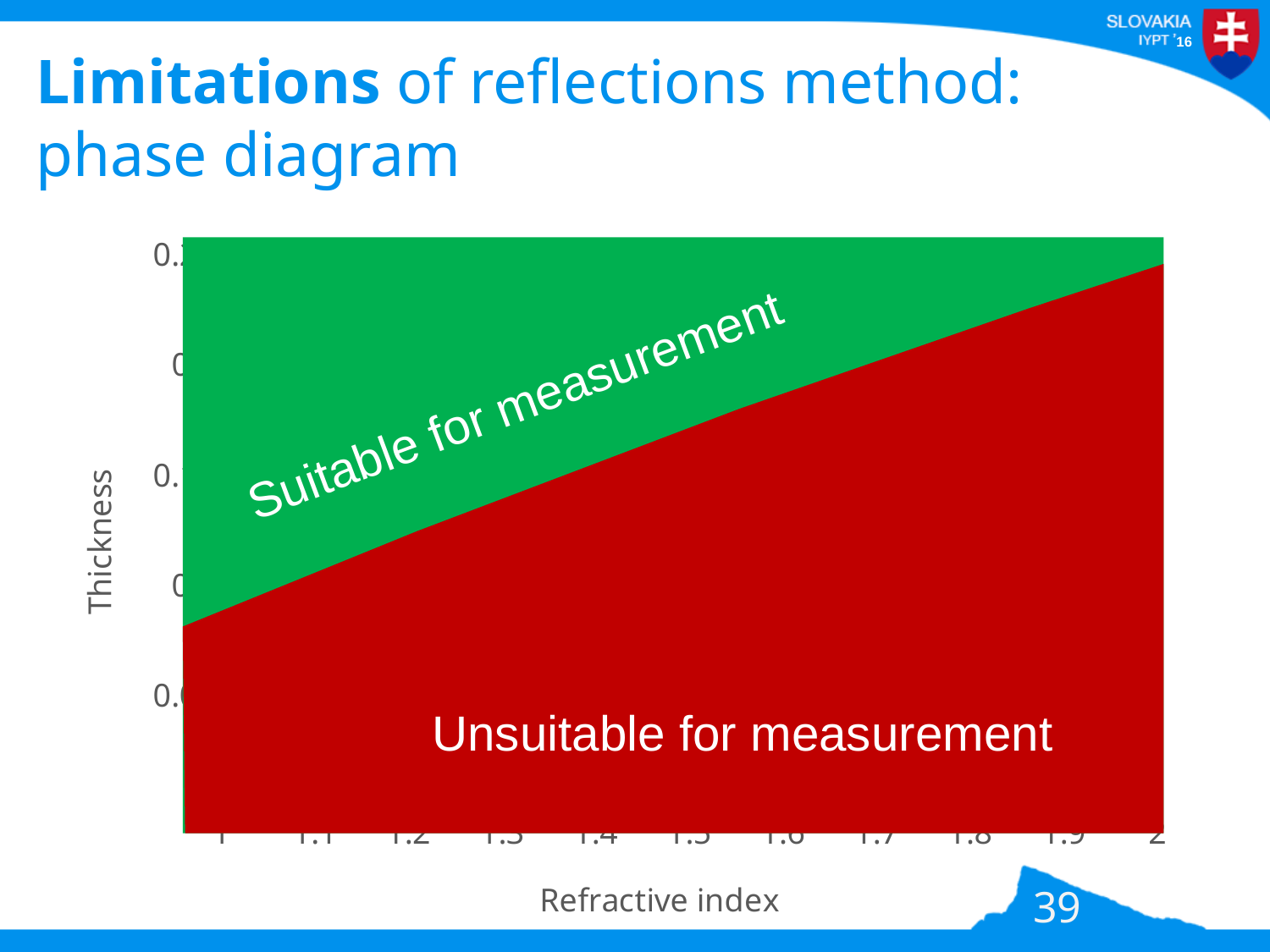
As the refractive index increases along the x axis, does the boundary between the suitable and unsuitable regions rise or fall? rise What is the label of the x axis of the phase diagram? Refractive index What is the label of the green region in the phase diagram? Suitable for measurement What is the label of the y axis of the phase diagram? Thickness Which region covers a larger area of the plot, the suitable or the unsuitable region? Unsuitable for measurement Is the thickness range that is suitable for measurement larger at a refractive index of 1 or at a refractive index of 2? 1 How many regions does the phase diagram divide the plot area into? 2 What kind of chart is shown on the slide? phase diagram What is the label of the red region in the phase diagram? Unsuitable for measurement What is the lowest refractive index value shown on the x axis? 1 What is the highest refractive index value shown on the x axis? 2